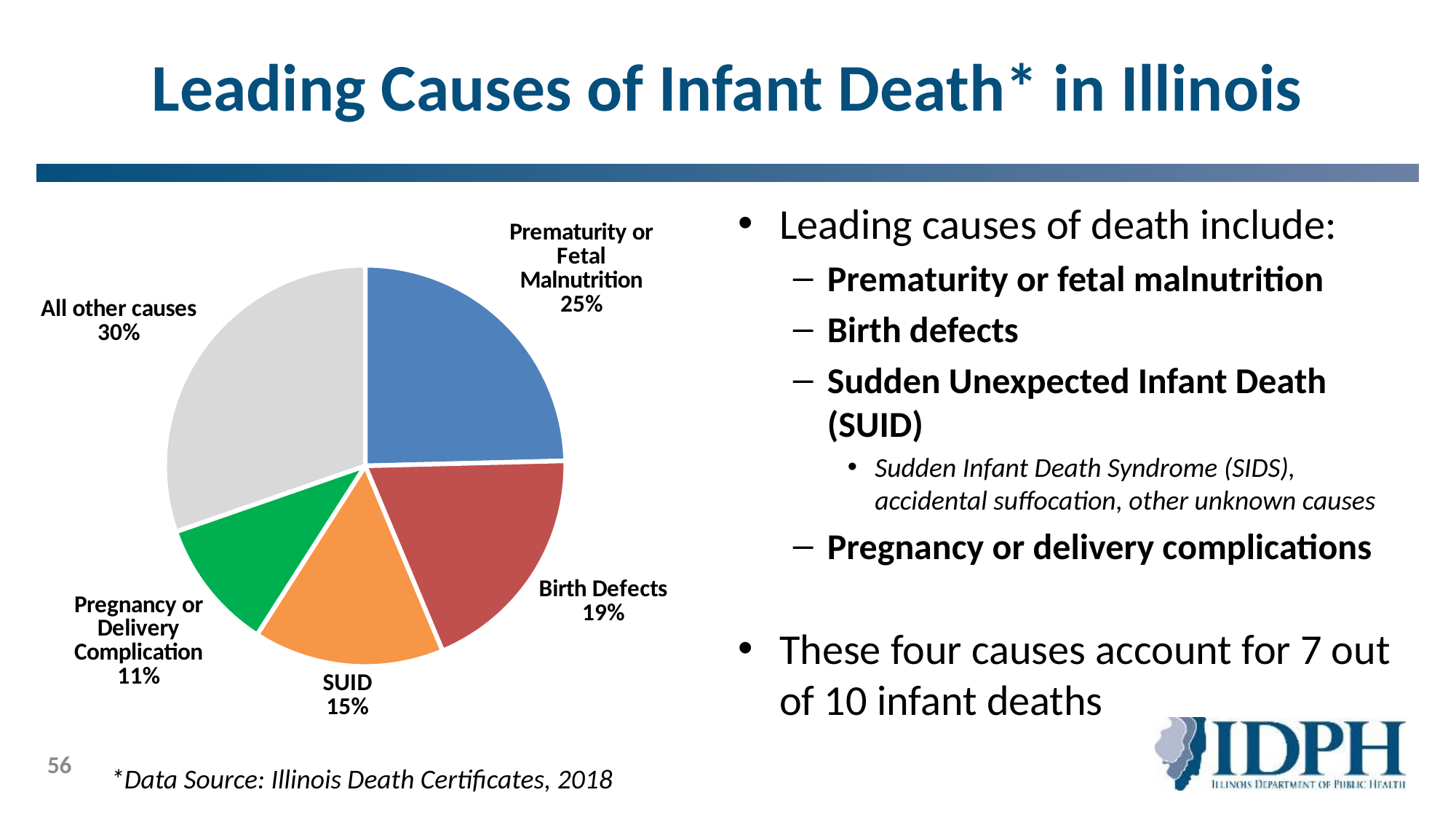
What share of the pie is All other causes? 30% What share does SUID account for? 15% Which slice of the pie is the largest? All other causes Which is larger, the SUID slice or the Pregnancy or Delivery Complication slice? SUID How many slices does the pie chart have? 5 What percentage is shown for Pregnancy or Delivery Complication? 11% What is the difference in percentage points between Prematurity or Fetal Malnutrition and Birth Defects? 6 What kind of chart is shown on the slide? Pie chart Which slice of the pie is the smallest? Pregnancy or Delivery Complication What percentage of the pie is Birth Defects? 19% What colour is the Birth Defects slice? Red What share of infant deaths is attributed to Prematurity or Fetal Malnutrition? 25%